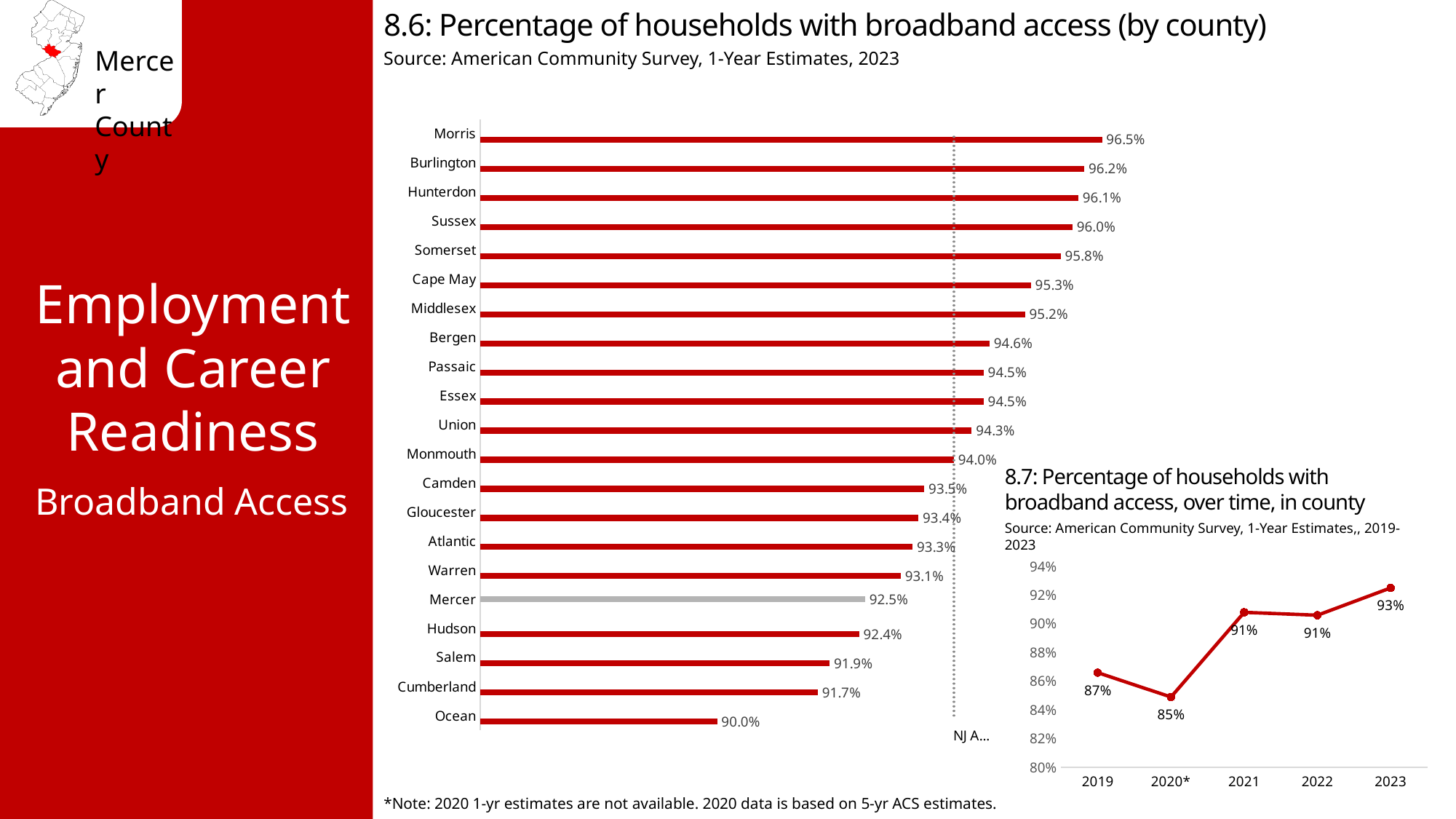
In chart 8.7 (broadband access over time in county), what is the value for 2023? 93% In chart 8.6 (by county), how many counties are shown? 21 In chart 8.6 (Percentage of households with broadband access by county), what is the value for Mercer? 92.5% In chart 8.6 (by county), which county has the highest percentage of households with broadband access? Morris In chart 8.6 (by county), what is the difference between the values for Morris and Ocean? 6.5% What kind of chart is chart 8.7 (Percentage of households with broadband access over time in county)? Line chart In chart 8.7 (broadband access over time in county), what is the difference between the 2023 and 2019 values? 6% In chart 8.7 (broadband access over time in county), what is the value for 2020*? 85% In chart 8.6 (by county), which has a higher value, Hudson or Salem? Hudson In chart 8.6 (by county), which county has the lowest percentage of households with broadband access? Ocean What kind of chart is chart 8.6 (Percentage of households with broadband access by county)? Bar chart In chart 8.6 (by county), what is the value for Cumberland? 91.7%